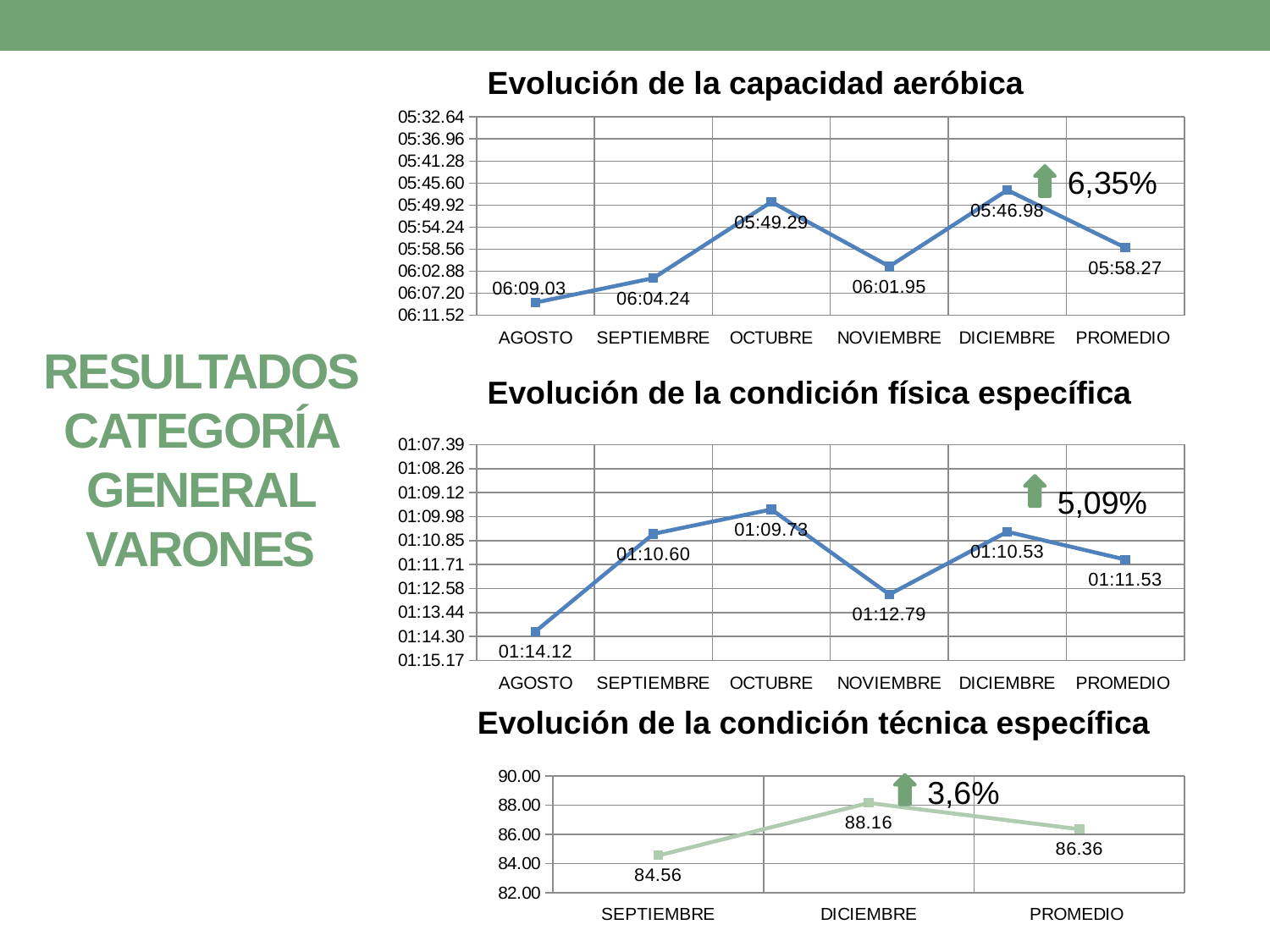
In the chart 'Evolución de la condición técnica específica', how many categories are plotted on the x axis? 3 In the chart 'Evolución de la condición técnica específica', what is the value for DICIEMBRE? 88.16 In the chart 'Evolución de la condición física específica', what is the value for AGOSTO? 01:14.12 In the chart 'Evolución de la condición física específica', what is the value for NOVIEMBRE? 01:12.79 In the chart 'Evolución de la condición física específica', which category has the lowest (fastest) time value? OCTUBRE In the chart 'Evolución de la condición técnica específica', what is the difference between the DICIEMBRE and SEPTIEMBRE values? 3.60 In the chart 'Evolución de la condición técnica específica', which is larger, the value for SEPTIEMBRE or the value for PROMEDIO? PROMEDIO In the chart 'Evolución de la capacidad aeróbica', how many categories are plotted on the x axis? 6 In the chart 'Evolución de la capacidad aeróbica', what is the value for PROMEDIO? 05:58.27 In the chart 'Evolución de la capacidad aeróbica', what is the value for OCTUBRE? 05:49.29 What kind of chart is 'Evolución de la condición técnica específica'? Line chart In the chart 'Evolución de la capacidad aeróbica', which category has the lowest (fastest) time value? DICIEMBRE